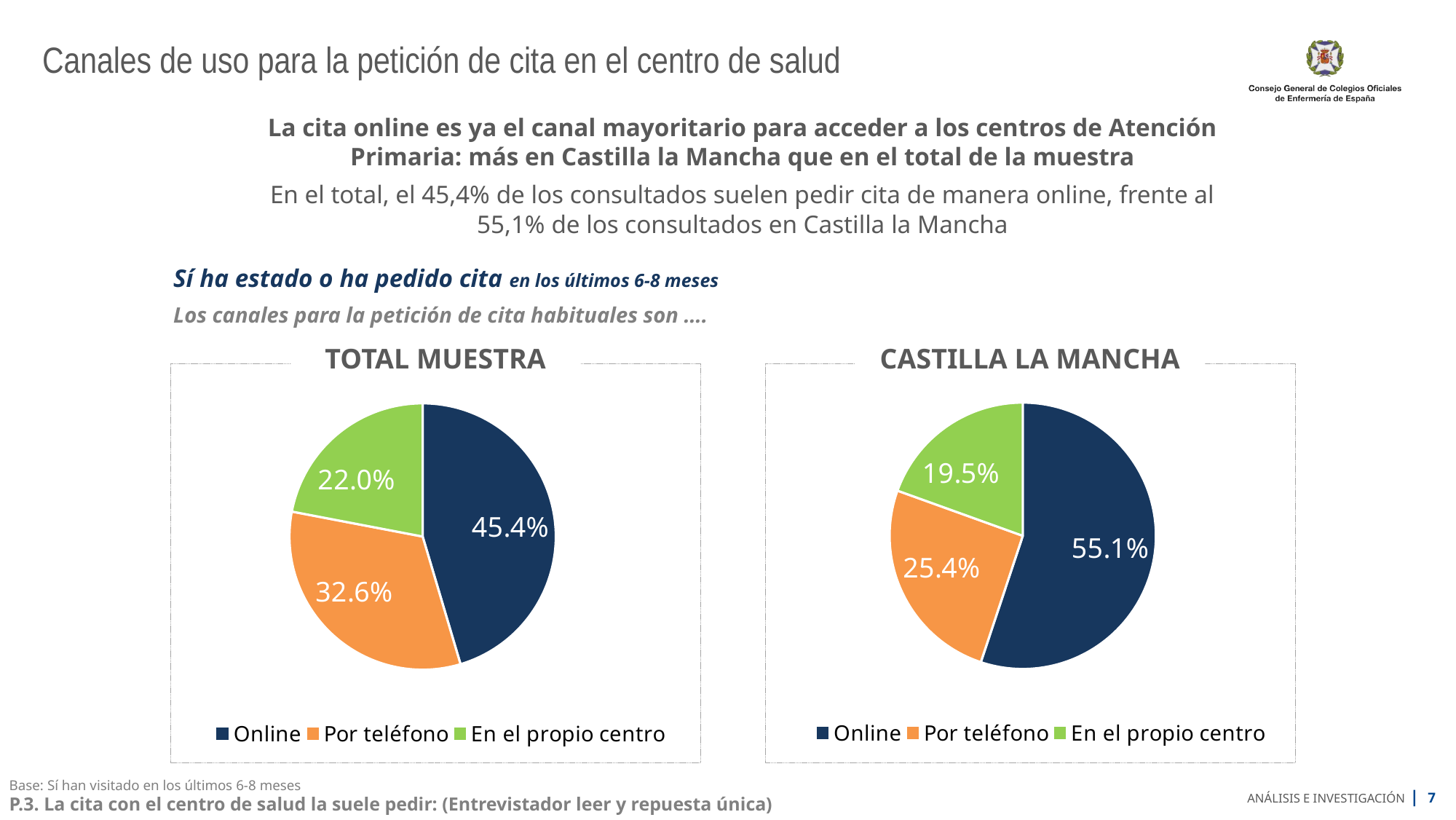
In the TOTAL MUESTRA chart, which channel has the smallest slice? En el propio centro How many slices does the CASTILLA LA MANCHA chart have? 3 In the TOTAL MUESTRA chart, what share of respondents request appointments Online? 45.4% In the CASTILLA LA MANCHA chart, what is the value for Por teléfono? 25.4% Which is larger: Por teléfono in the TOTAL MUESTRA chart or Por teléfono in the CASTILLA LA MANCHA chart? TOTAL MUESTRA How many entries does the legend of the TOTAL MUESTRA chart list? 3 What is the difference between the Online share in the CASTILLA LA MANCHA chart and the Online share in the TOTAL MUESTRA chart? 9.7 percentage points In the CASTILLA LA MANCHA chart, what colour is the Online slice? Dark blue In the TOTAL MUESTRA chart, what is the value for En el propio centro? 22.0% What type of chart is used for TOTAL MUESTRA? Pie chart In the TOTAL MUESTRA chart, what is the difference between Por teléfono and En el propio centro? 10.6 percentage points In the CASTILLA LA MANCHA chart, which channel has the largest slice? Online